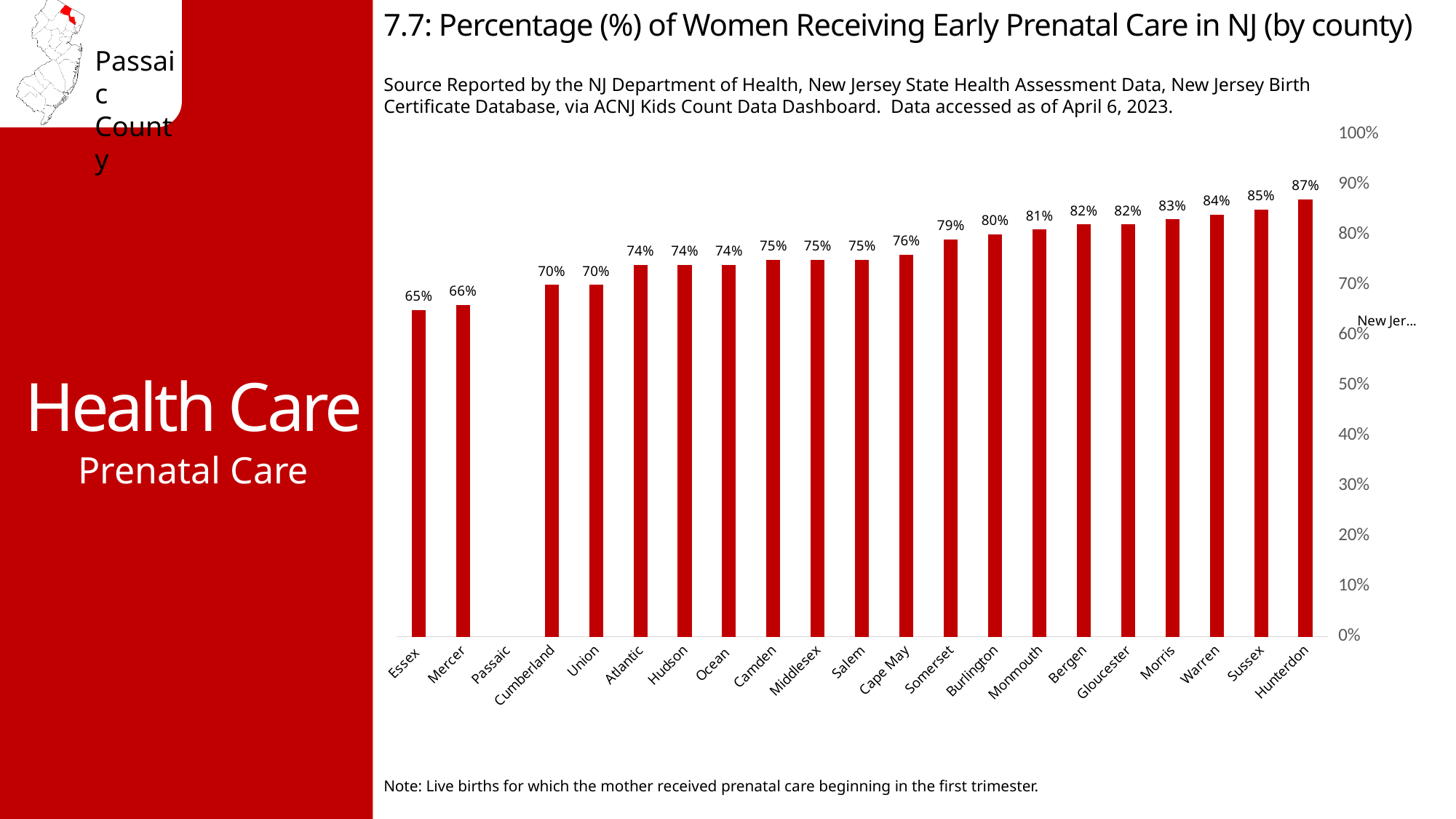
Which county on the x axis has no bar plotted? Passaic What is the value for Somerset? 79% Which is larger, the value for Morris or the value for Mercer? Morris What is the value for Cape May? 76% Which county with a plotted bar has the lowest percentage? Essex Do the values generally rise or fall moving from left to right along the x axis? Rise What is the difference between the values for Hunterdon and Essex? 22% What is the value for Hunterdon? 87% What is the value for Essex? 65% What kind of chart is shown on the slide? Bar chart What is the difference between the values for Bergen and Cumberland? 12% Which county has the highest percentage of women receiving early prenatal care? Hunterdon